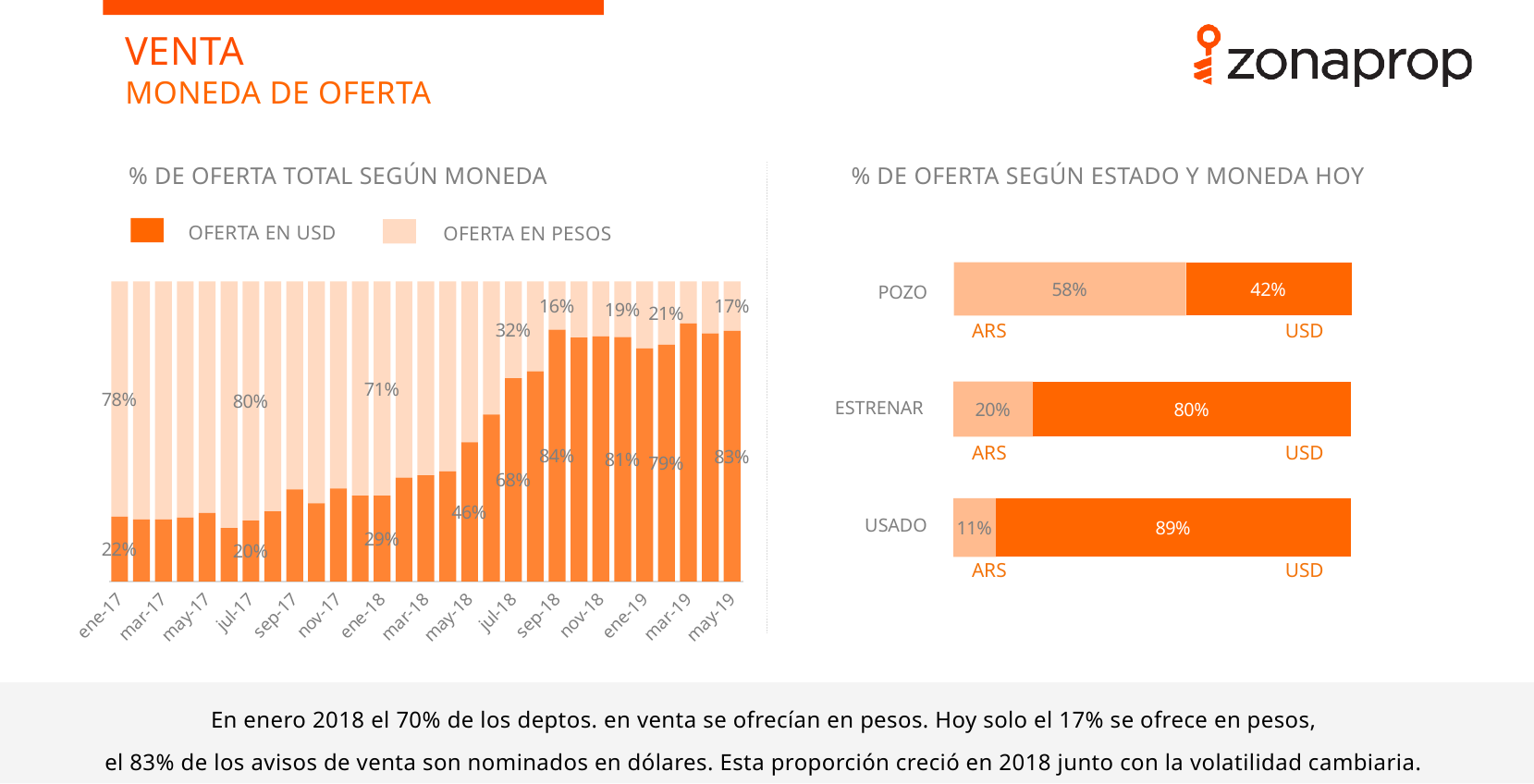
In the chart '% DE OFERTA TOTAL SEGÚN MONEDA', how many series does the legend list? 2 In the chart '% DE OFERTA SEGÚN ESTADO Y MONEDA HOY', which category has the highest USD share? USADO In the chart '% DE OFERTA SEGÚN ESTADO Y MONEDA HOY', what is the USD share for USADO? 89% In the chart '% DE OFERTA SEGÚN ESTADO Y MONEDA HOY', which category has the lowest USD share? POZO In the chart '% DE OFERTA SEGÚN ESTADO Y MONEDA HOY', what is the difference between the USD share for ESTRENAR and the USD share for POZO? 38% In the chart '% DE OFERTA TOTAL SEGÚN MONEDA', does the OFERTA EN USD share generally rise or fall from ene-17 to may-19? rise In the chart '% DE OFERTA TOTAL SEGÚN MONEDA', what is the OFERTA EN USD value for may-19? 83% In the chart '% DE OFERTA TOTAL SEGÚN MONEDA', what is the OFERTA EN USD value for sep-18? 84% In the chart '% DE OFERTA TOTAL SEGÚN MONEDA', what is the OFERTA EN PESOS value for ene-17? 78% In the chart '% DE OFERTA SEGÚN ESTADO Y MONEDA HOY', what is the ARS share for POZO? 58% In the chart '% DE OFERTA SEGÚN ESTADO Y MONEDA HOY', how many categories are shown? 3 What kind of chart is '% DE OFERTA TOTAL SEGÚN MONEDA'? stacked bar chart